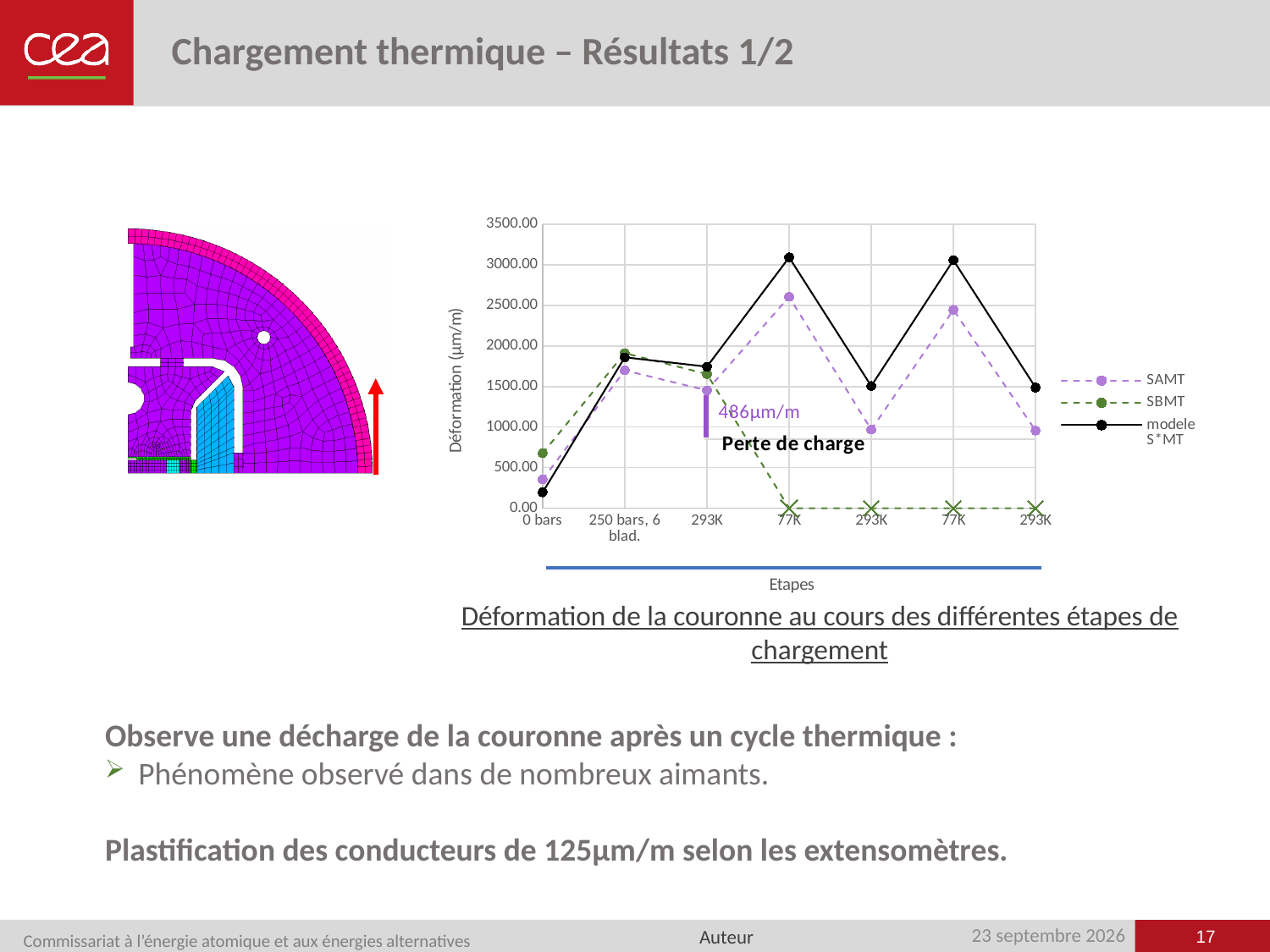
Is the value of the SAMT series at the first 77K stage greater or less than 2500? greater Which series has the lowest value at the first 77K stage? SBMT How many series does the chart legend list? 3 Is the value of the SBMT series at the first 77K stage greater or less than 500? less How many stages (categories) are plotted along the x axis of the chart? 7 Which series has the highest value at the first 77K stage? modele S*MT What kind of chart is shown on the slide? line chart Is the value of the modele S*MT series at the first 77K stage greater or less than 3000? greater What is the title of the x axis of the chart? Etapes What is the title of the y axis of the chart? Déformation (µm/m) At the '250 bars, 6 blad.' stage, which series has the larger value, SAMT or SBMT? SBMT